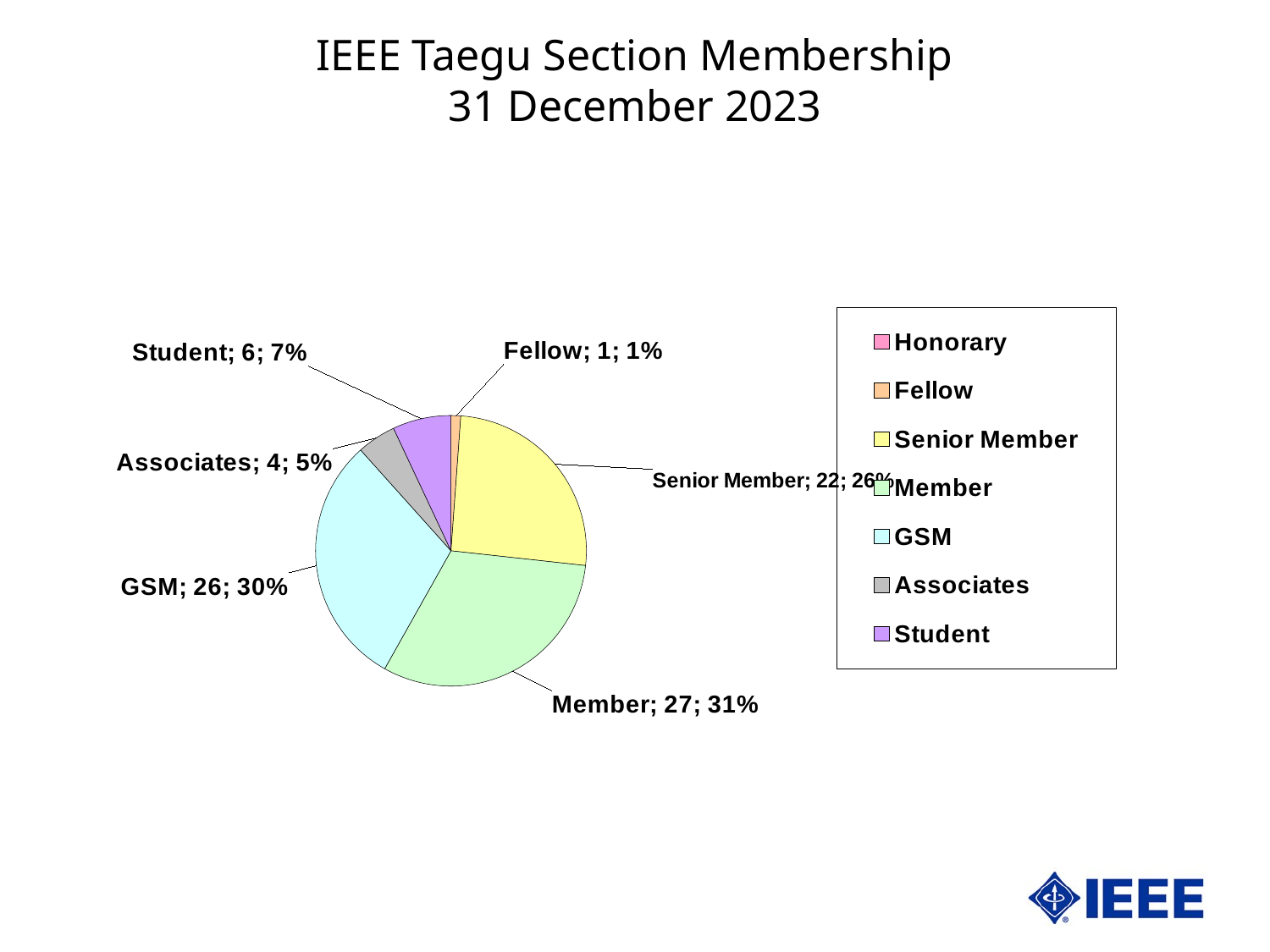
What percentage of the membership is GSM? 30% Which category has the largest slice of the pie? Member What share of the pie does the Student slice represent? 7% Which has more members, GSM or Senior Member? GSM What kind of chart is shown on the slide? pie chart Which labelled slice is the smallest? Fellow How many entries does the legend list? 7 What is the difference in count between Member and Senior Member? 5 What colour is the Senior Member slice? yellow How many members does the Member category have? 27 What is the title of the chart? IEEE Taegu Section Membership 31 December 2023 How many Senior Members are shown? 22